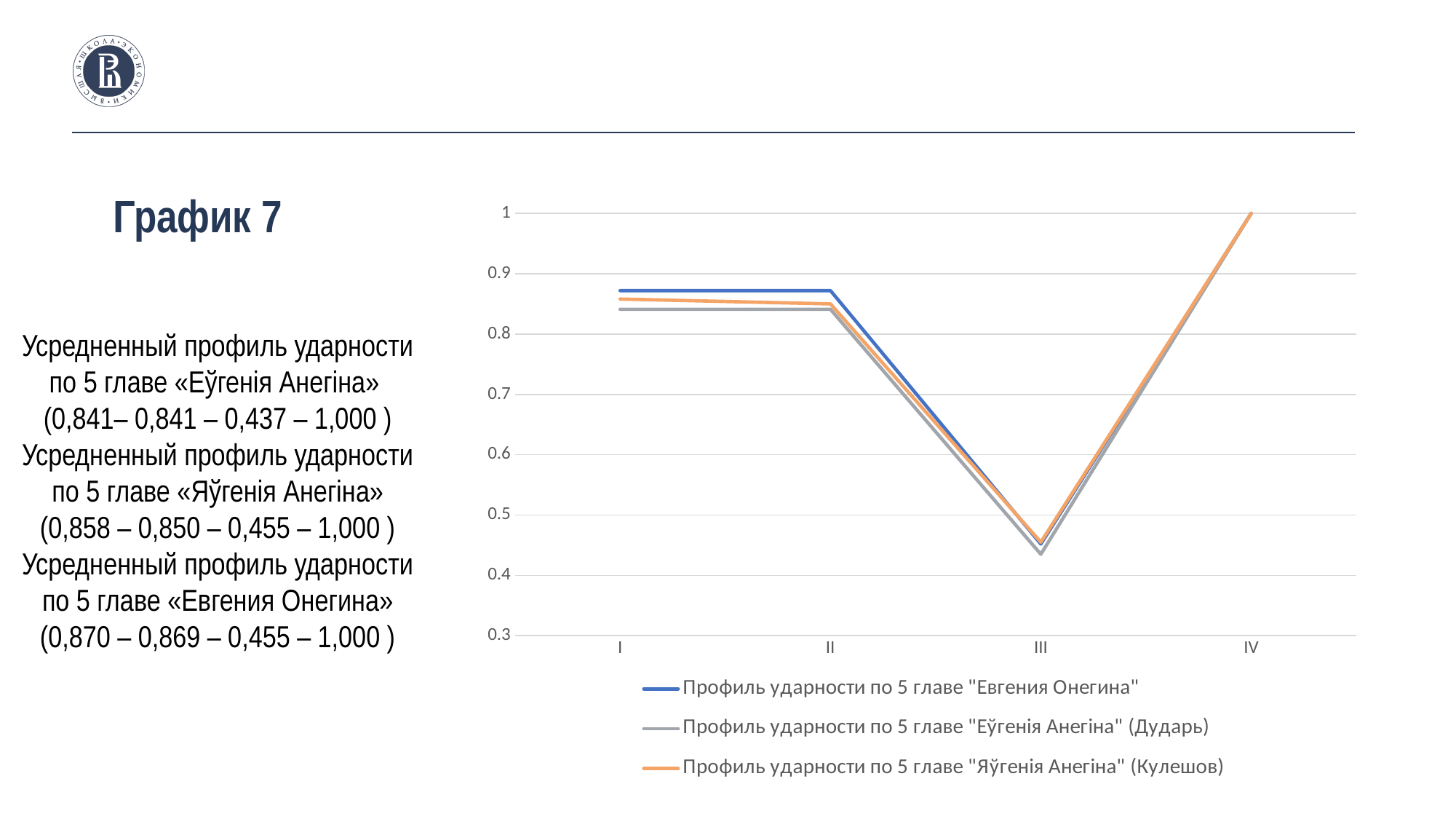
Do the values of the series rise or fall from position III to position IV? rise How many series does the chart legend list? 3 Which series has the higher value at position I: "Евгения Онегина" or "Еўгенія Анегіна" (Дударь)? Евгения Онегина What kind of chart is shown on the slide? line chart What is the title shown to the left of the chart? График 7 How many points are plotted along the x axis for each series? 4 At which x-axis position do all three series reach their highest value? IV Is the value of the series "Еўгенія Анегіна" (Дударь) at position I greater or less than 0.8? greater According to the text on the slide, what is the value of the averaged stress profile for «Евгения Онегина» at position I? 0,870 Is the value of the series "Евгения Онегина" at position III greater or less than 0.5? less According to the text on the slide, what is the value of the averaged stress profile for «Еўгенія Анегіна» at position III? 0,437 At which x-axis position do all three series reach their lowest value? III